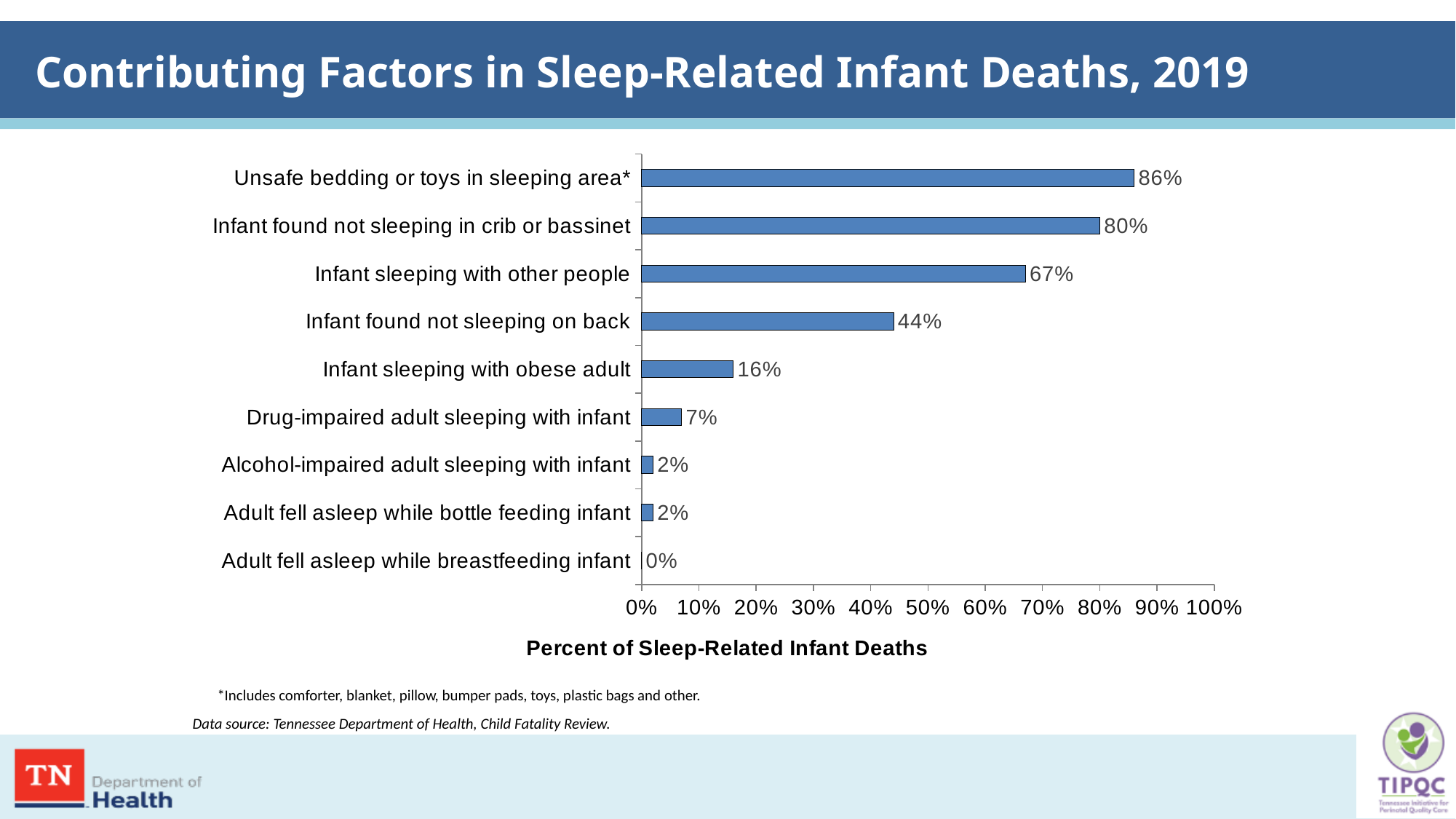
What is the difference between 'Unsafe bedding or toys in sleeping area*' and 'Infant found not sleeping in crib or bassinet'? 6% Which contributing factor has the highest percentage? Unsafe bedding or toys in sleeping area* Which contributing factor has the lowest percentage? Adult fell asleep while breastfeeding infant What is the value for 'Infant found not sleeping on back'? 44% What is the difference between 'Infant found not sleeping on back' and 'Infant sleeping with obese adult'? 28% What is the x-axis title of the chart? Percent of Sleep-Related Infant Deaths What is the value for 'Drug-impaired adult sleeping with infant'? 7% What kind of chart is shown on the slide? Bar chart What percent of sleep-related infant deaths involved unsafe bedding or toys in the sleeping area? 86% What is the value for 'Infant sleeping with other people'? 67% Which is larger: 'Infant sleeping with obese adult' or 'Drug-impaired adult sleeping with infant'? Infant sleeping with obese adult How many contributing factors are shown in the chart? 9